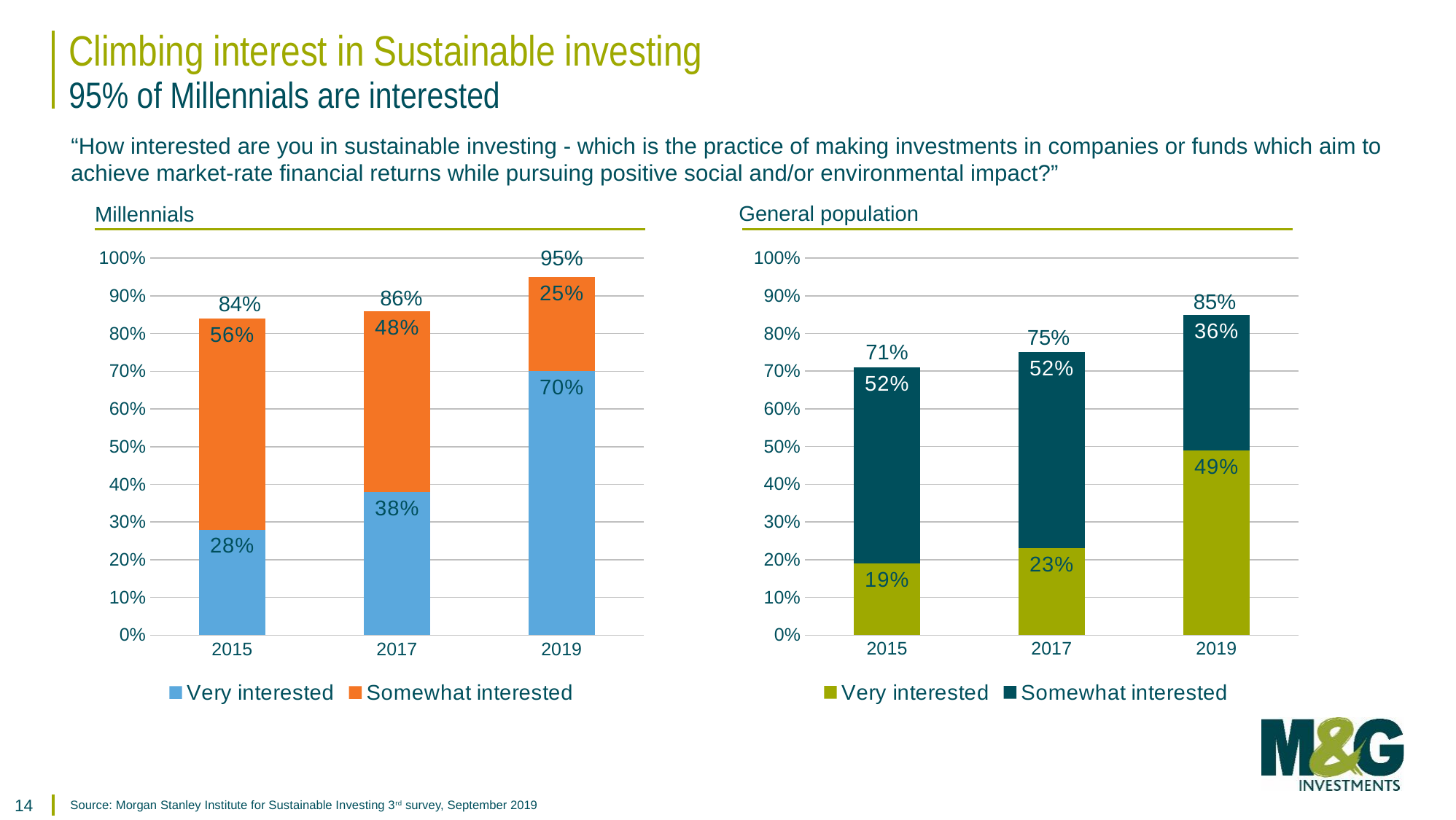
In the Millennials chart, what is the difference between the 'Very interested' values for 2019 and 2015? 42% How many series does the legend of the General population chart list? 2 In the Millennials chart, how many years are shown on the x axis? 3 In the Millennials chart, what is the total of the stacked bar for 2017? 86% In the Millennials chart, what is the 'Very interested' value for 2019? 70% In the General population chart, do the 'Very interested' values rise or fall from 2015 to 2019? Rise In the General population chart, which is larger for 2019: 'Very interested' or 'Somewhat interested'? Very interested In the General population chart, which year has the lowest 'Very interested' value? 2015 In the General population chart, what is the total of the stacked bar for 2019? 85% In the Millennials chart, which year has the highest 'Very interested' value? 2019 In the General population chart, what is the 'Somewhat interested' value for 2015? 52% What kind of chart is the Millennials chart? Stacked bar chart